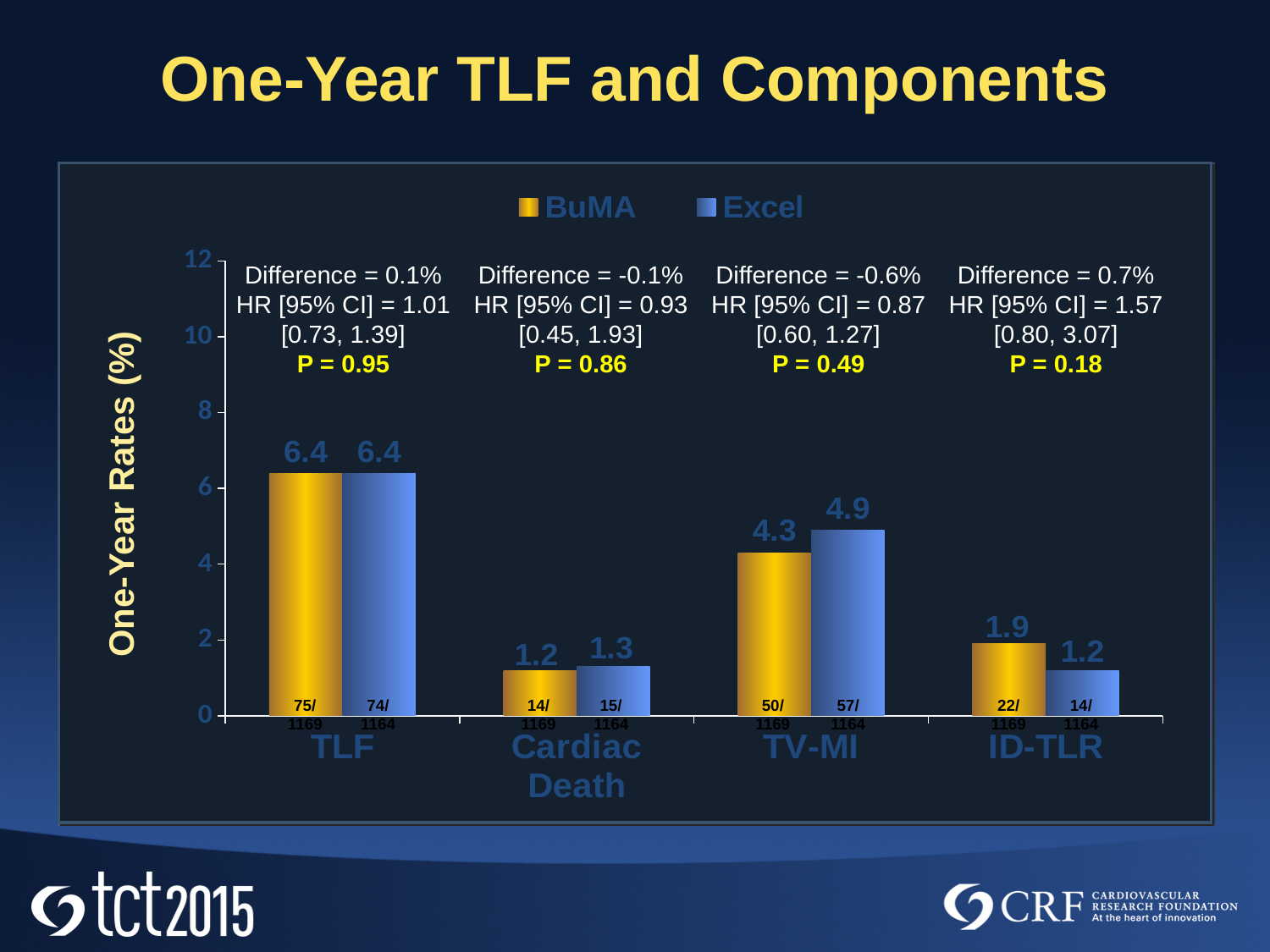
What is the P value shown for the TV-MI category? P = 0.49 What is the one-year rate for Excel in the Cardiac Death category? 1.3 Which category has the lowest one-year rate for BuMA? Cardiac Death How many categories are shown on the x axis? 4 In the ID-TLR category, which series has the larger one-year rate, BuMA or Excel? BuMA What is the one-year rate for BuMA in the TLF category? 6.4 Which category has the highest one-year rate for Excel? TLF What is the one-year rate for Excel in the TV-MI category? 4.9 How many series does the legend list? 2 What is the difference between the Excel and BuMA one-year rates in the TV-MI category? 0.6 What is the one-year rate for BuMA in the ID-TLR category? 1.9 What kind of chart is shown on the slide? Bar chart